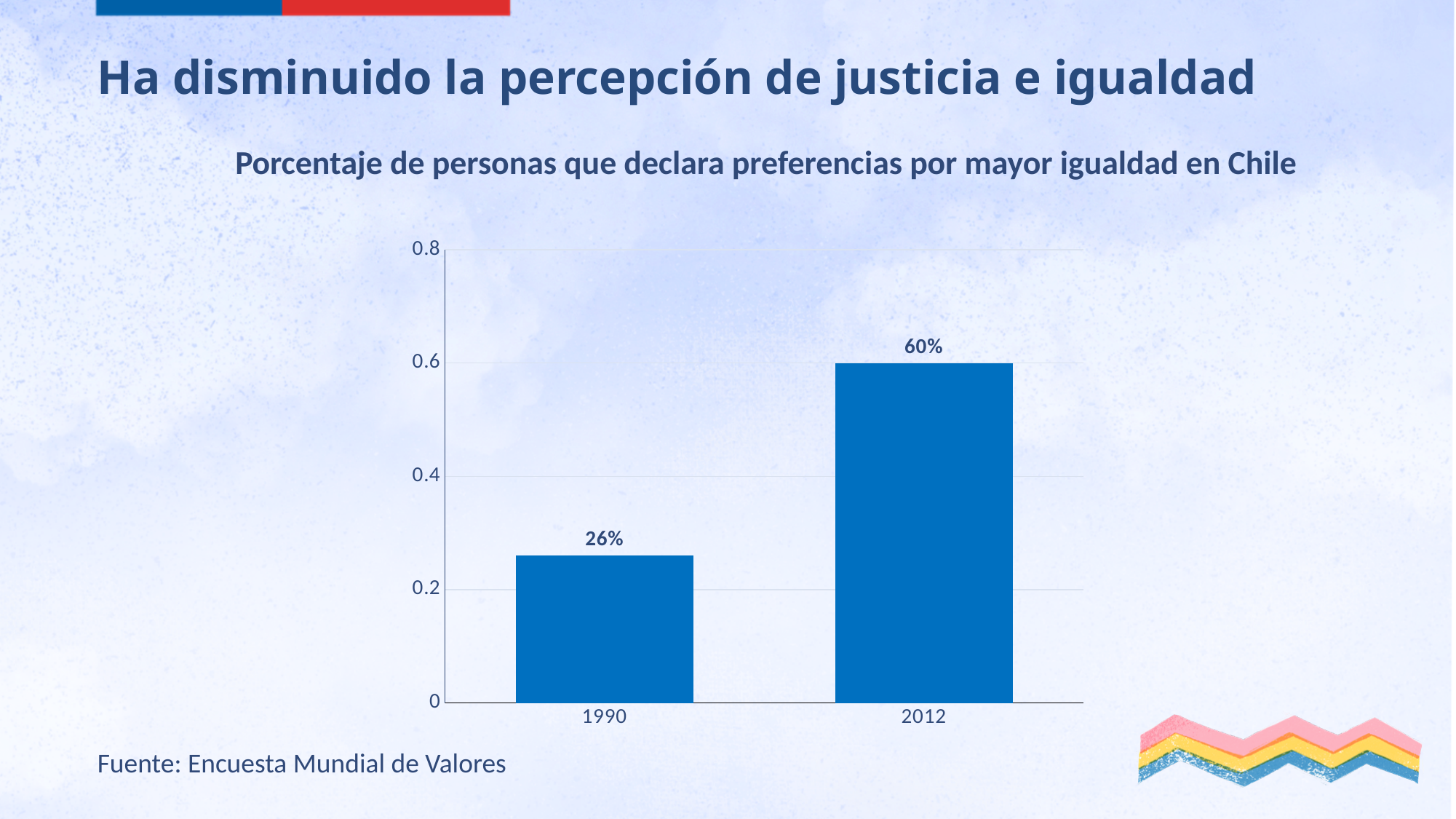
What is the value for 2012? 60% What is the difference between the values for 2012 and 1990? 34% Is the value for 2012 greater or less than 0.4? greater Do the values rise or fall from 1990 to 2012? rise What is the title of the chart? Porcentaje de personas que declara preferencias por mayor igualdad en Chile Which year has the highest value? 2012 Is the value for 1990 greater or less than 0.4? less What kind of chart is shown on the slide? bar chart How many years are shown on the x axis? 2 What is the value for 1990? 26% Which year has the lowest value? 1990 Which is larger, the value for 1990 or the value for 2012? 2012